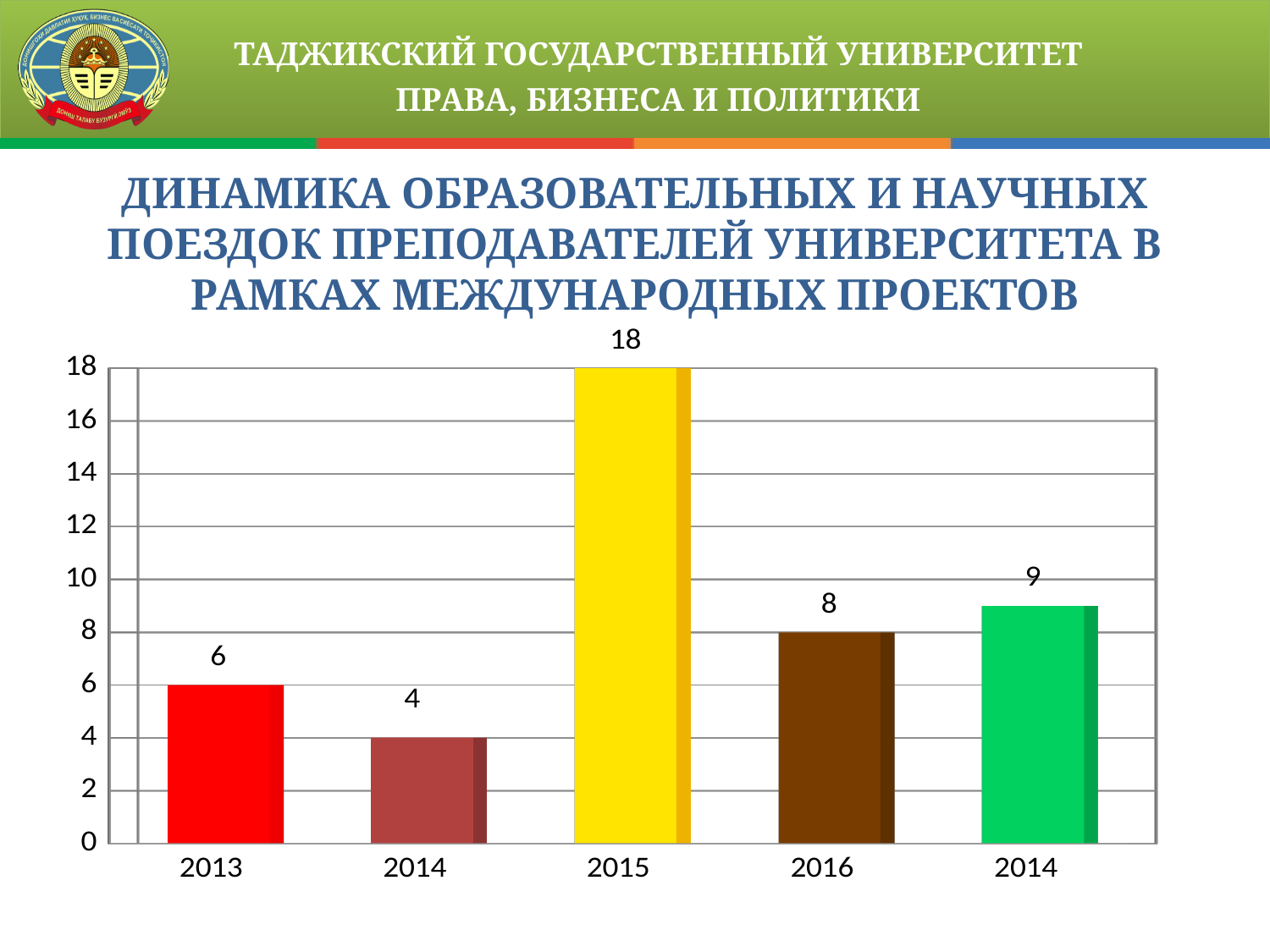
Which category has the highest value? 2015 What colour is the bar for 2015? Yellow What kind of chart is shown on the slide? Bar chart What is the value of the rightmost bar (the second bar labelled 2014)? 9 What is the value of the second bar from the left (the first bar labelled 2014)? 4 What is the value for 2016? 8 Which is larger, the value for 2013 or the value for 2016? 2016 What is the difference between the values for 2015 and 2016? 10 What is the value for 2013? 6 What is the lowest value shown on the chart? 4 What is the value for 2015? 18 How many bars are shown on the chart? 5